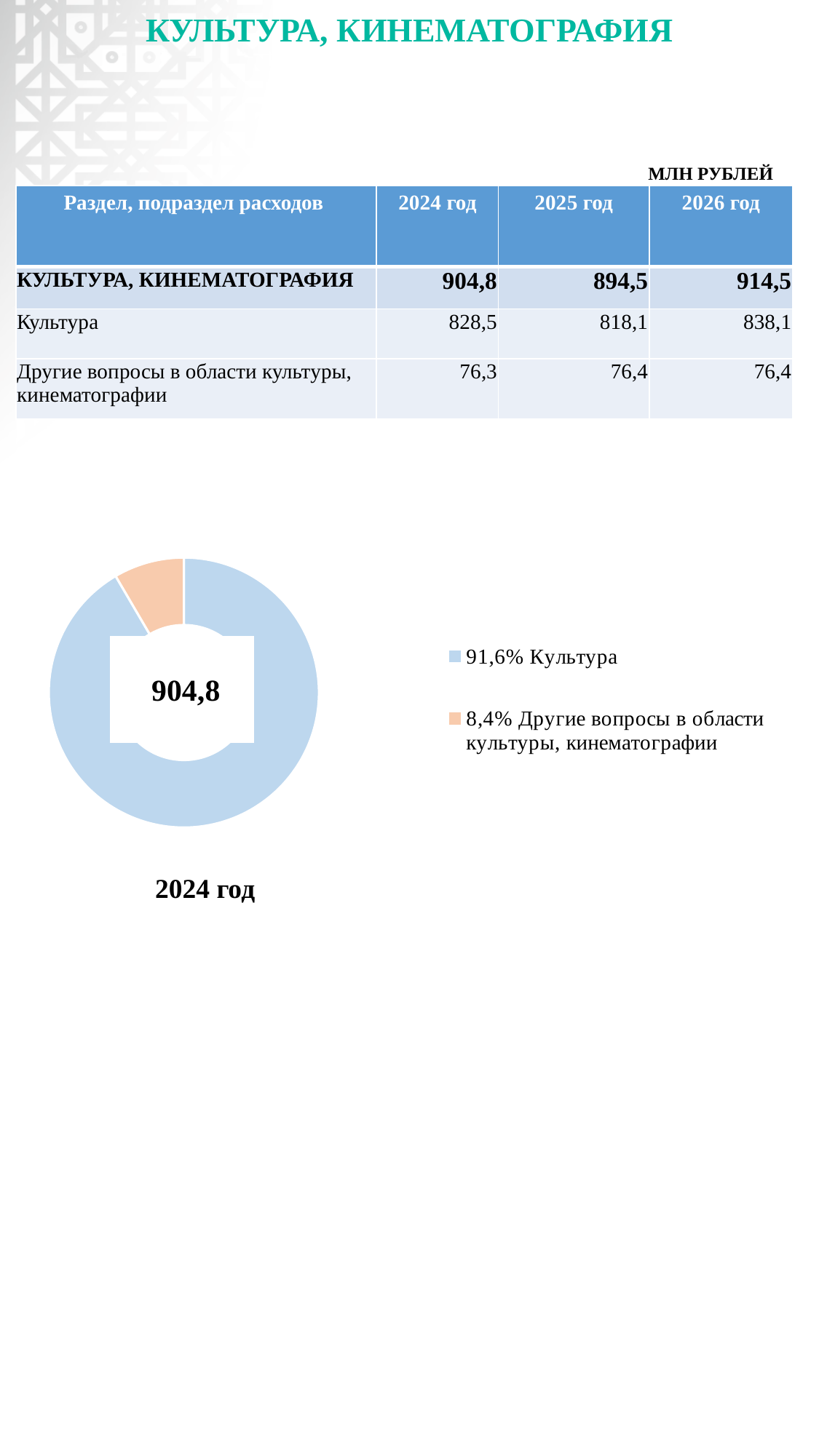
What kind of chart is shown on the slide? Doughnut (pie) chart What is the difference in percentage points between the Культура share and the Другие вопросы в области культуры, кинематографии share in the doughnut chart? 83,2 Which slice of the doughnut chart is the largest? Культура How many slices does the doughnut chart have? 2 Which is larger in the doughnut chart: the share for Культура or the share for Другие вопросы в области культуры, кинематографии? Культура What colour is the Культура slice in the doughnut chart? Light blue Which slice of the doughnut chart is the smallest? Другие вопросы в области культуры, кинематографии What total value is printed in the centre of the doughnut chart? 904,8 Which year does the doughnut chart represent, according to the label beneath it? 2024 год How many entries does the legend of the doughnut chart list? 2 What share of the doughnut chart does Другие вопросы в области культуры, кинематографии take? 8,4% What share of the doughnut chart does Культура take? 91,6%